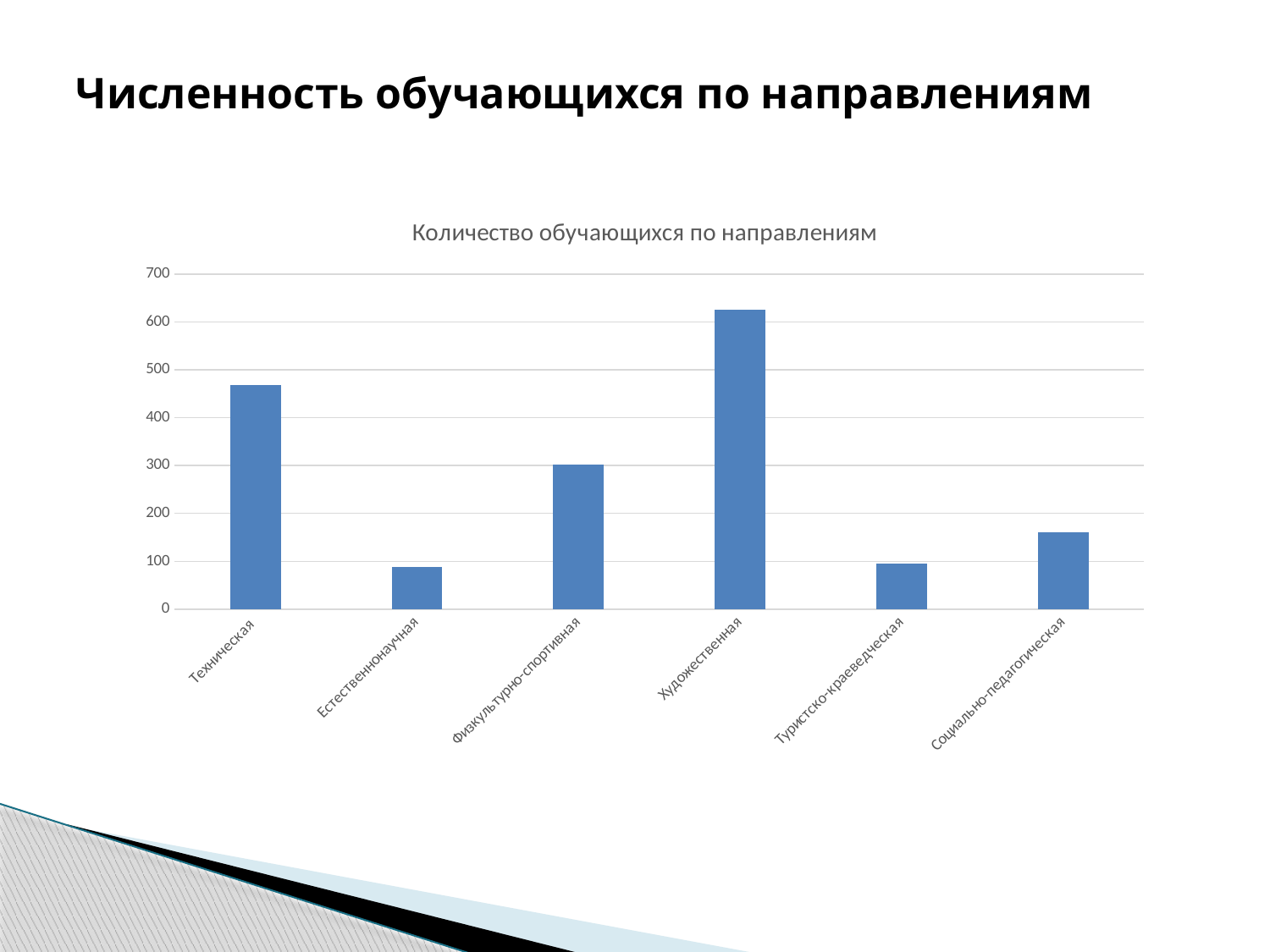
Is the value for Техническая greater or less than 400? greater Is the value for Естественнонаучная greater or less than 100? less Which is larger, the value for Техническая or the value for Физкультурно-спортивная? Техническая Is the value for Социально-педагогическая greater or less than 200? less What kind of chart is shown on the slide? bar chart Which is larger, the value for Социально-педагогическая or the value for Туристско-краеведческая? Социально-педагогическая Which category has the highest number of students? Художественная What is the title of the chart? Количество обучающихся по направлениям How many categories (направления) are shown on the chart? 6